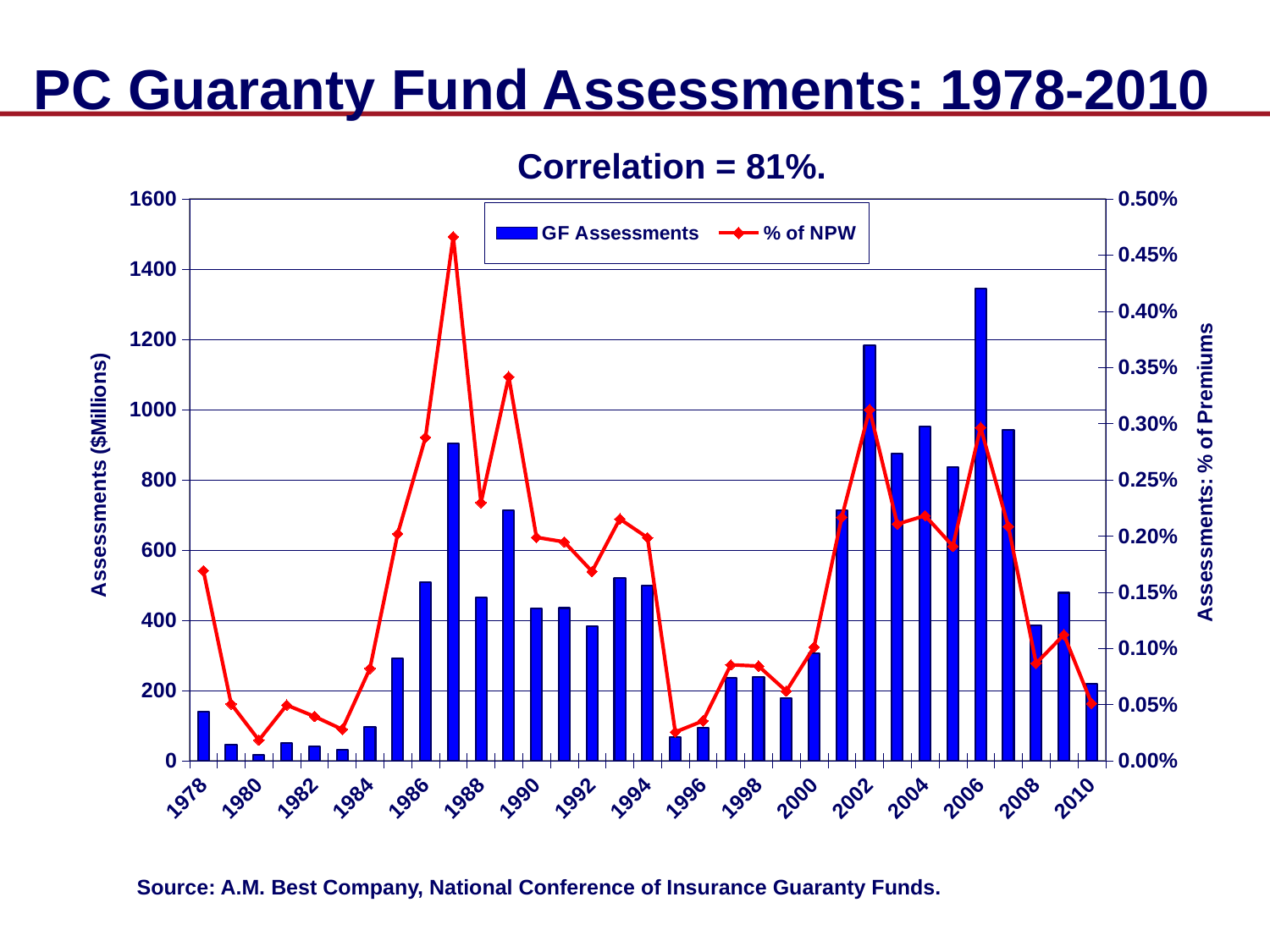
In which year is the GF Assessments bar the highest? 2006 In which year does the % of NPW line reach its highest point? 1987 Do the GF Assessments bars rise or fall from 2006 to 2010? fall In which year is the GF Assessments bar the lowest? 1980 What correlation value is stated in the chart title? 81% How many years are plotted along the x axis? 33 Is the GF Assessments value for 2006 greater or less than 1200? greater Is the % of NPW value for 1987 greater or less than 0.40%? greater How many series does the legend list? 2 Which year has the larger GF Assessments bar, 2002 or 2004? 2002 Is the GF Assessments value for 1980 greater or less than 200? less What kind of chart is shown on the slide? Combined bar and line chart